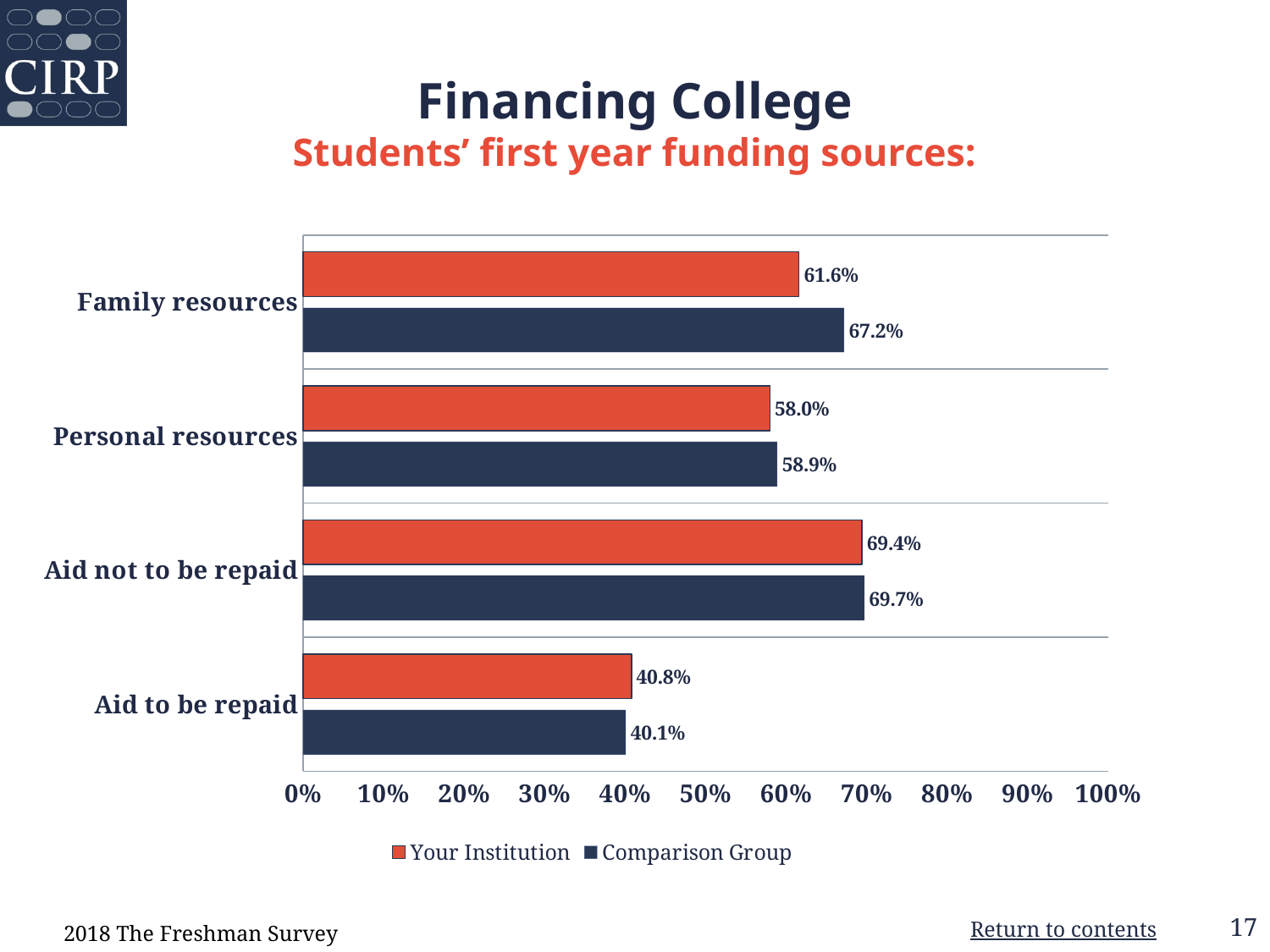
What is the value for Your Institution for Family resources? 61.6% How many categories are shown on the chart? 4 What kind of chart is shown on the slide? Bar chart What is the value for Comparison Group for Aid to be repaid? 40.1% Is the Your Institution value for Personal resources greater or less than 50%? greater What is the difference between the Comparison Group and Your Institution values for Family resources? 5.6% Which colour represents Comparison Group in the legend? Dark blue For Aid to be repaid, which is larger: Your Institution or Comparison Group? Your Institution Which category has the lowest value for Comparison Group? Aid to be repaid What is the value for Comparison Group for Personal resources? 58.9% How many series does the legend list? 2 Which category has the highest value for Your Institution? Aid not to be repaid